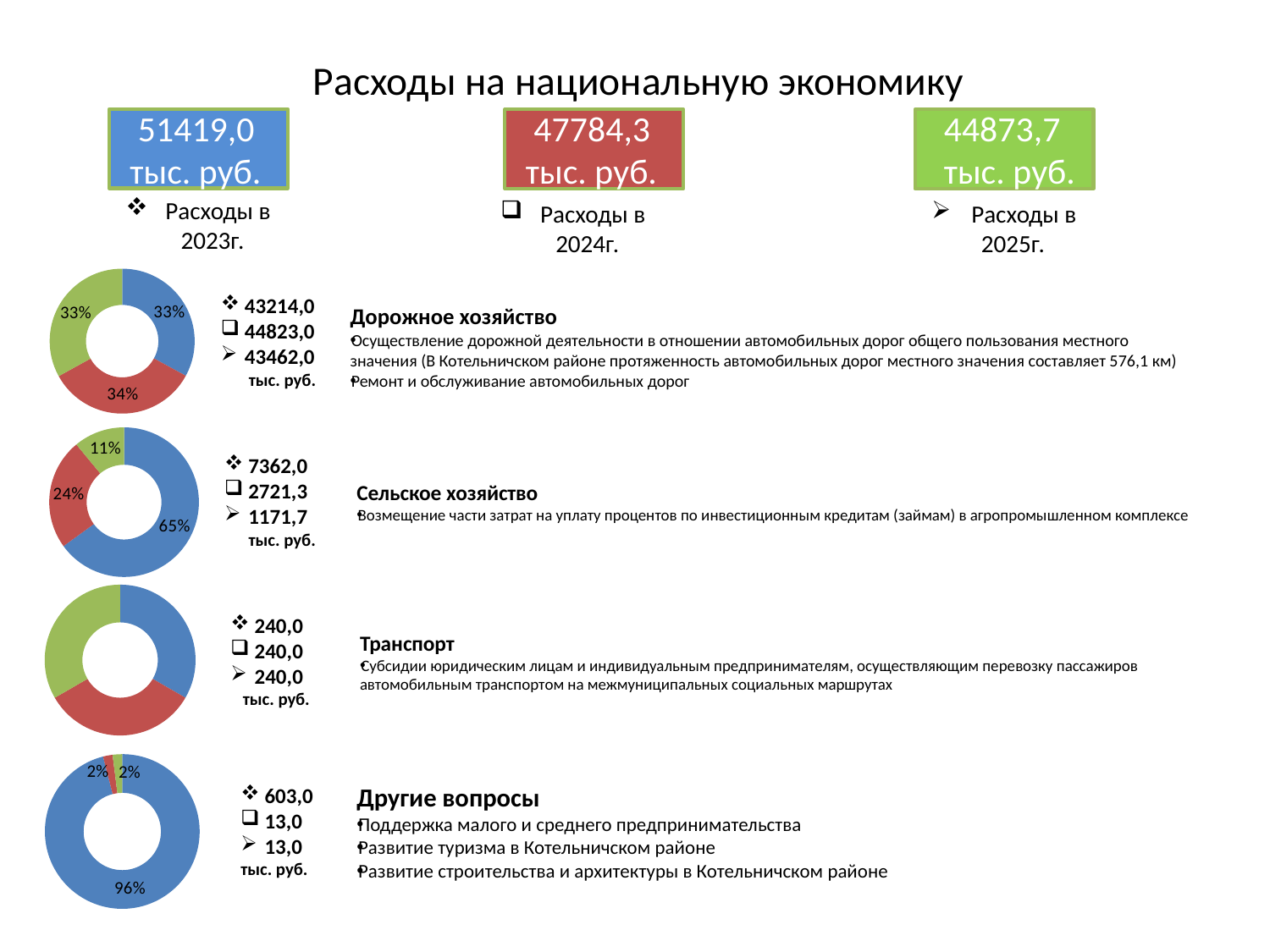
In the second donut chart (next to "Сельское хозяйство"), which slice is the largest? The blue slice (65%) In the top donut chart (next to "Дорожное хозяйство"), what share is shown for the blue slice? 33% How many donut charts are shown on the slide? 4 In the top donut chart (next to "Дорожное хозяйство"), what share is shown for the red slice? 34% In the bottom donut chart (next to "Другие вопросы"), is the red slice larger or smaller than the blue slice? Smaller In the second donut chart (next to "Сельское хозяйство"), what share is shown for the blue slice? 65% How many slices does the top donut chart (next to "Дорожное хозяйство") have? 3 In the second donut chart (next to "Сельское хозяйство"), what is the difference between the blue slice's share and the red slice's share? 41 percentage points In the second donut chart (next to "Сельское хозяйство"), which slice is the smallest? The green slice (11%) What kind of chart is used for the four charts on the left side of the slide? Pie (donut) chart